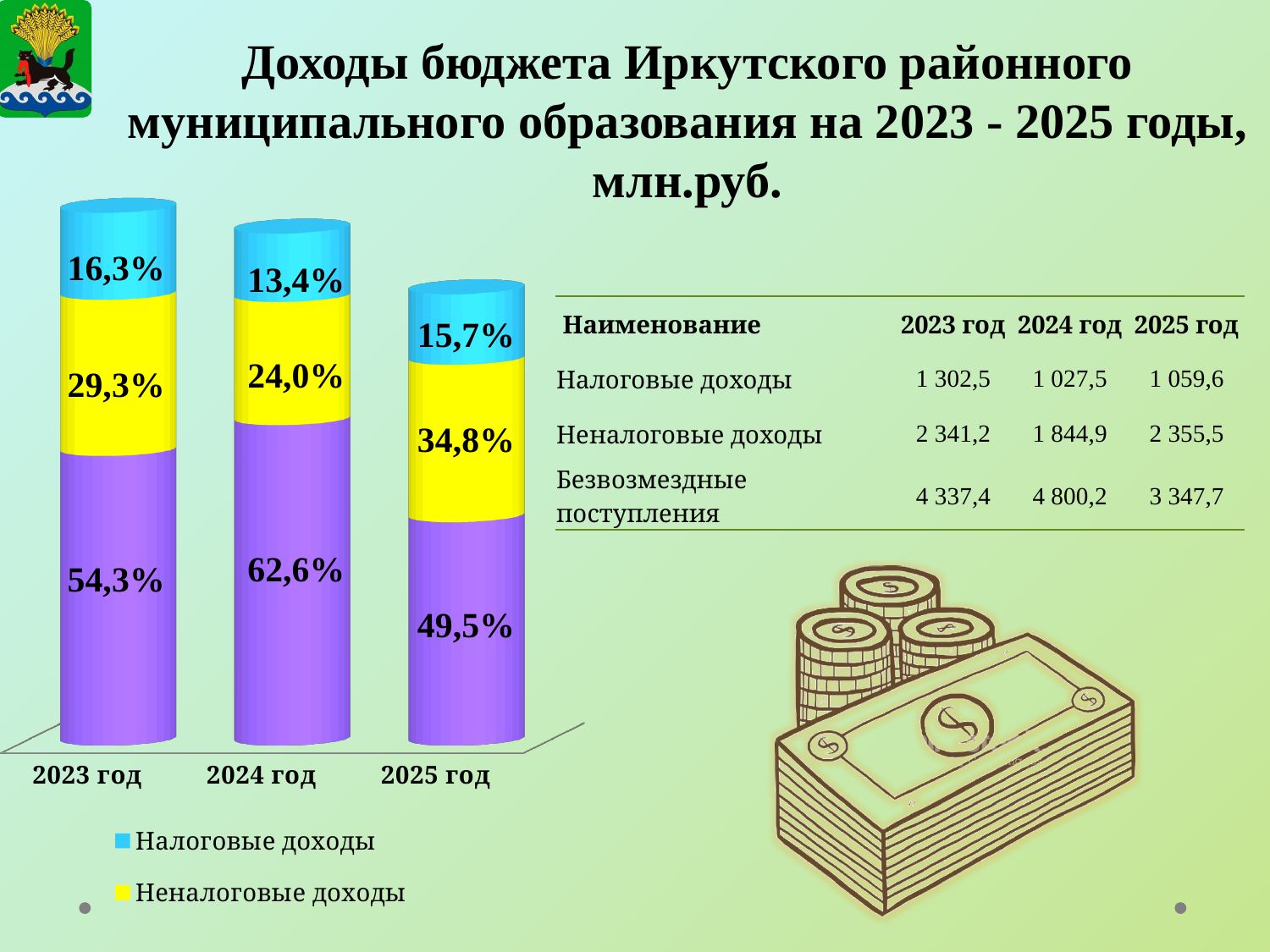
What is the difference between the Неналоговые доходы share in 2025 год and in 2024 год? 10,8% How many years (bars) are shown on the chart? 3 What is the share of Неналоговые доходы in 2025 год shown on the chart? 34,8% What is the share of Налоговые доходы in 2024 год shown on the chart? 13,4% Which is larger: the Налоговые доходы share in 2023 год or in 2025 год? 2023 год Which colour represents Налоговые доходы in the chart legend? Blue What type of chart is shown on the slide? Stacked bar chart What percentage is printed on the bottom purple segment of the 2024 год bar? 62,6% In which year is the share of Налоговые доходы the lowest? 2024 год In which year is the share of Неналоговые доходы the highest? 2025 год What is the share of Налоговые доходы in 2023 год shown on the chart? 16,3% Does the share of Неналоговые доходы rise or fall from 2023 год to 2024 год? Fall